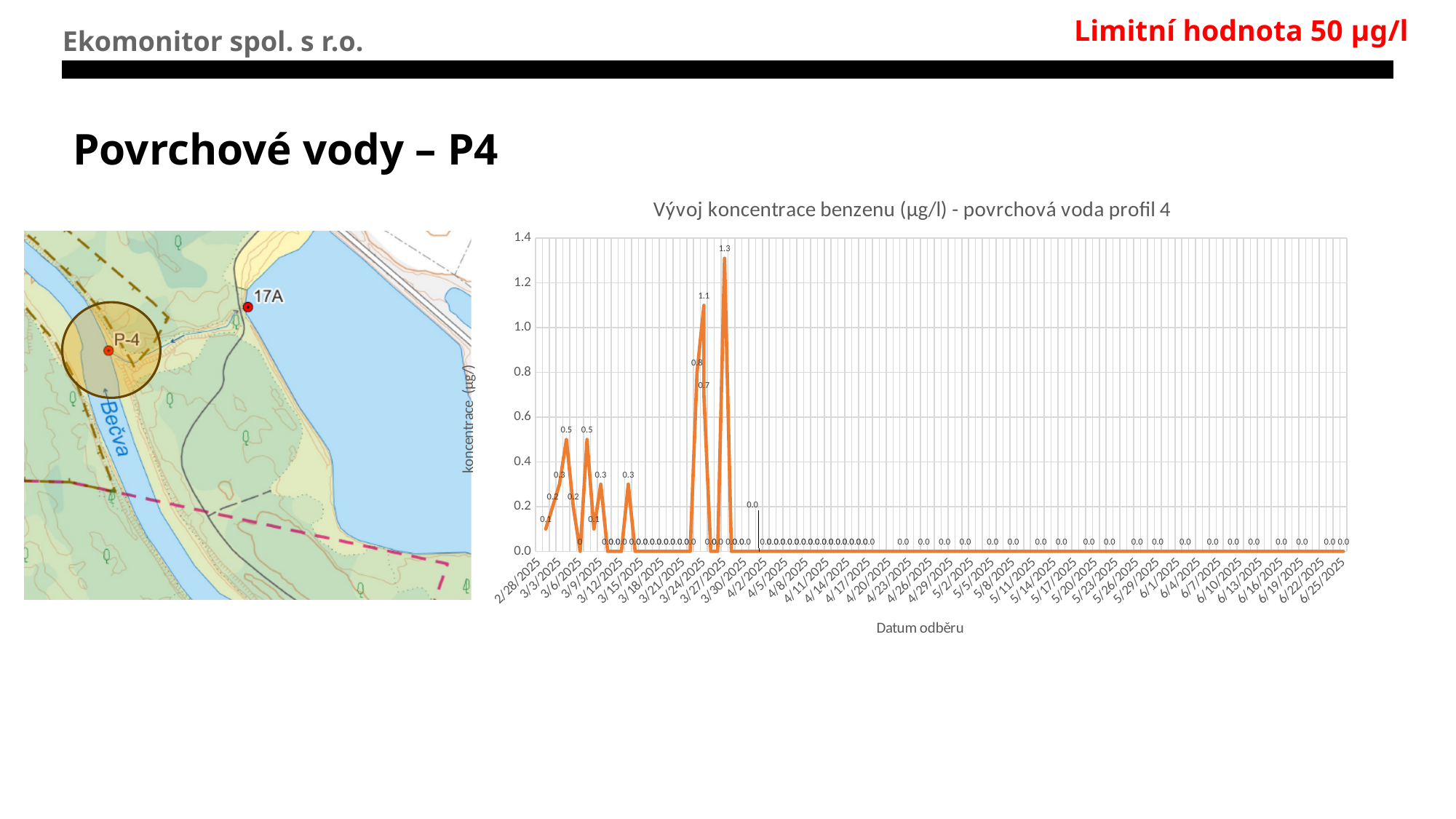
What is the highest benzene concentration value plotted on the chart? 1.3 Is the highest value on the chart greater or less than 1.0? greater What is the label of the vertical axis of the chart? koncentrace (µg/l) What is the benzene concentration value for 6/25/2025? 0.0 What is the difference between the highest peak (1.3) and the second highest peak (1.1) on the chart? 0.2 What type of chart is shown on the slide? line chart From mid-April to the end of June, do the plotted values rise, fall, or stay flat? stay flat Is the value for 6/25/2025 greater or less than 0.2? less What is the title of the chart? Vývoj koncentrace benzenu (µg/l) - povrchová voda profil 4 Which is larger, the peak labelled 1.3 or the peak labelled 0.8? 1.3 What is the lowest benzene concentration value plotted on the chart? 0.0